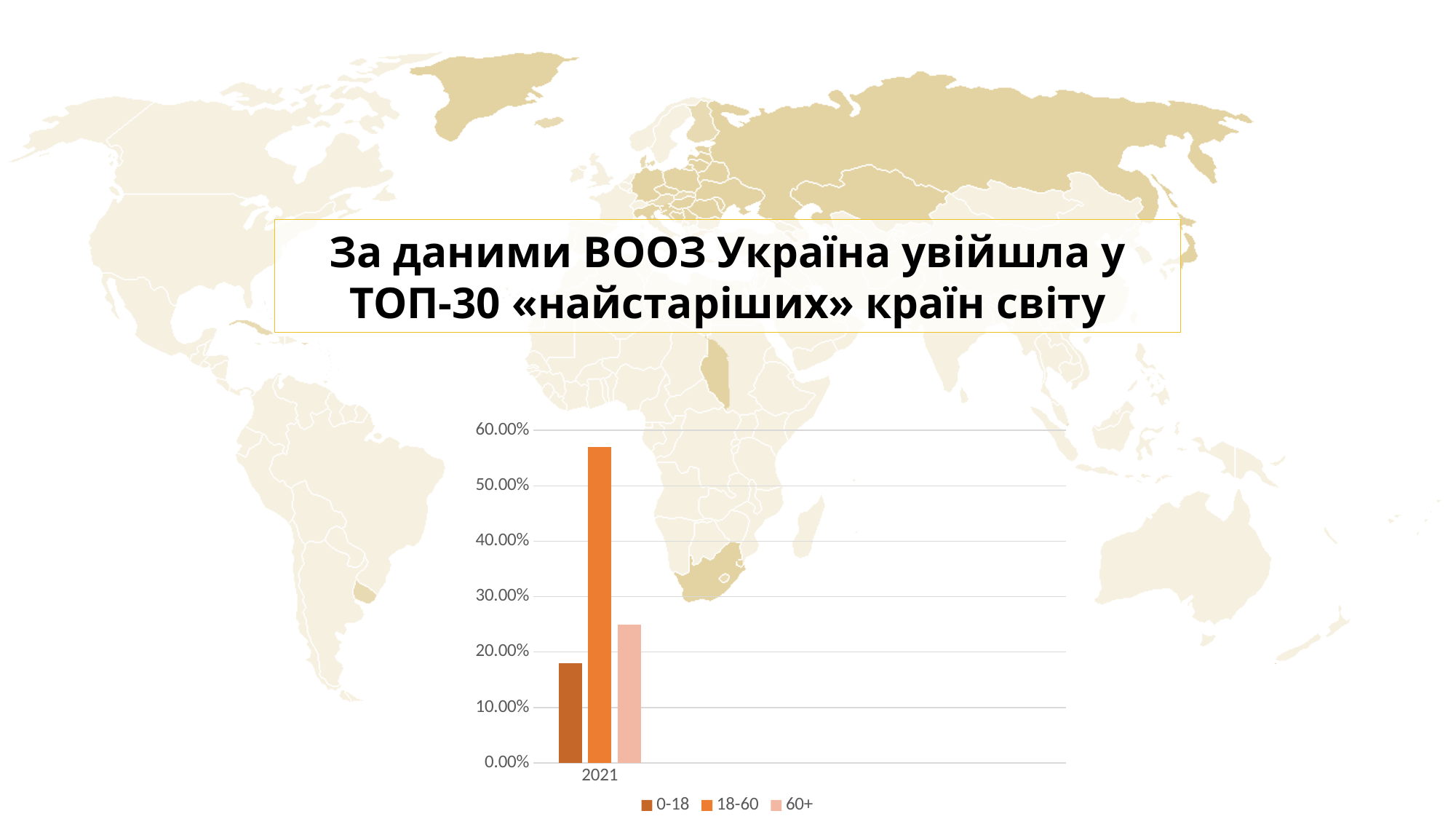
Which series has the highest value for 2021? 18-60 What are the three series listed in the legend? 0-18, 18-60, 60+ Which series has the lowest value for 2021? 0-18 Is the value for 0-18 greater or less than 20.00%? less How many categories are shown on the x axis? 1 Is the value for 60+ greater or less than 30.00%? less What kind of chart is shown on the slide? bar chart How many series does the legend list? 3 Which is larger for 2021, the value for 18-60 or the value for 60+? 18-60 Which category label appears on the x axis? 2021 Is the value for 18-60 greater or less than 50.00%? greater Which is larger for 2021, the value for 60+ or the value for 0-18? 60+